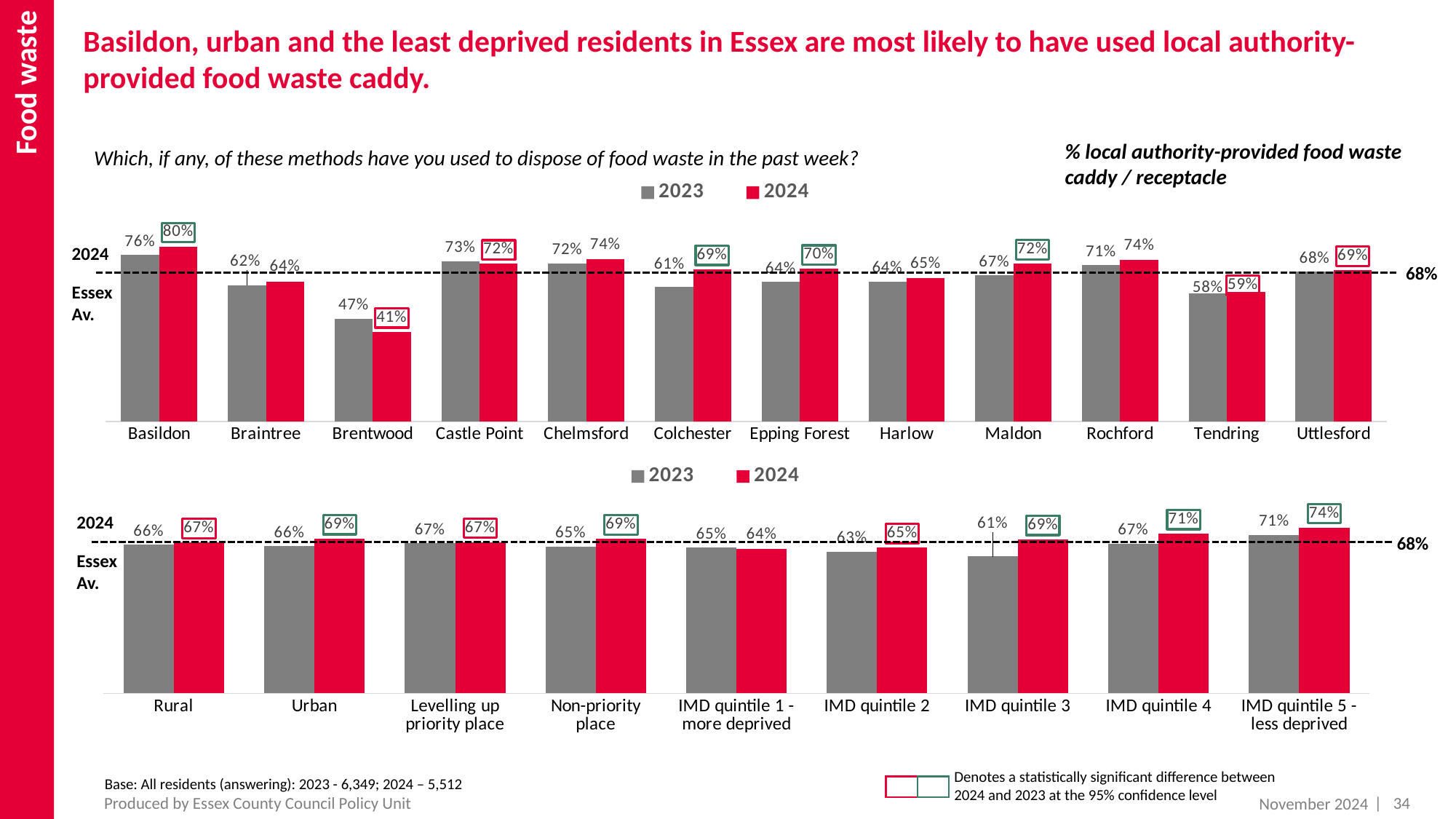
In the bottom chart, which category has the highest 2024 value? IMD quintile 5 - less deprived In the top chart (by district), what is the 2023 value for Brentwood? 47% In the bottom chart, how many series does the legend list? 2 In the top chart (by district), what is the difference between the 2024 and 2023 values for Colchester? 8 percentage points In the top chart (by district), what is the 2024 value for Basildon? 80% In the top chart (by district), which district has the lowest 2024 value? Brentwood In the top chart (by district), how many districts are shown on the x axis? 12 In the top chart (by district), what is the 2024 Essex average shown by the dashed line? 68% In the top chart (by district), which district has the highest 2024 value? Basildon In the bottom chart, is the 2024 value for Urban larger or the 2024 value for Rural? Urban In the bottom chart, what is the 2024 value for IMD quintile 3? 69% What type of chart is used on this slide? Bar chart